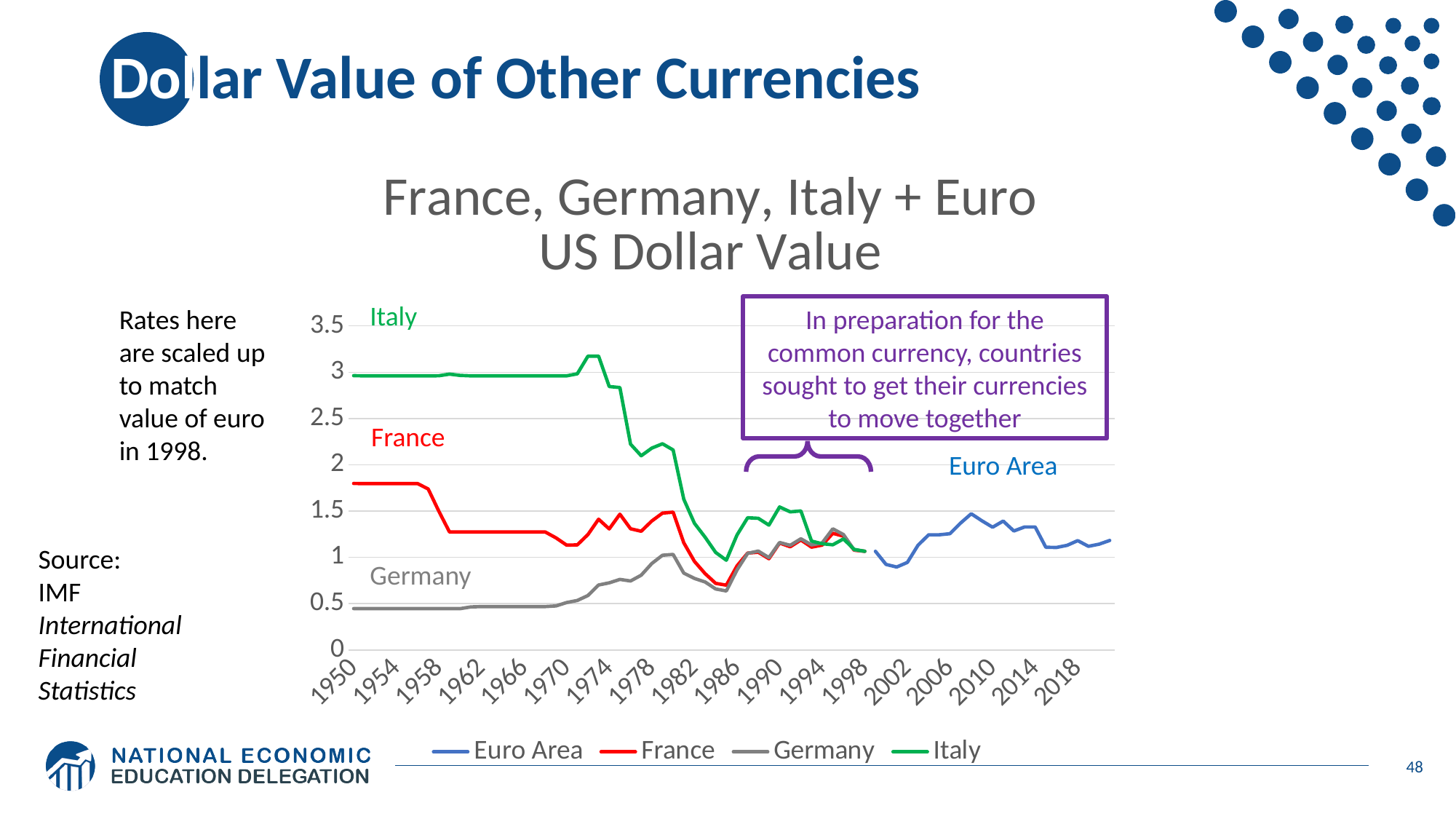
Which series are listed in the chart legend? Euro Area, France, Germany, Italy How many series does the chart legend list? 4 Is the value for Italy in 1950 greater or less than 2.5? greater What colour is the Italy line in the chart? green Is the value for Euro Area in 2010 greater or less than 1? greater Does the Italy line generally rise or fall between 1974 and 1986? fall Is the value for Germany in 1950 greater or less than 1? less Which series has the lowest value in 1950? Germany What kind of chart is shown on the slide? line chart Which series has the highest value in 1950? Italy In 1962, which is larger, the value for France or the value for Germany? France